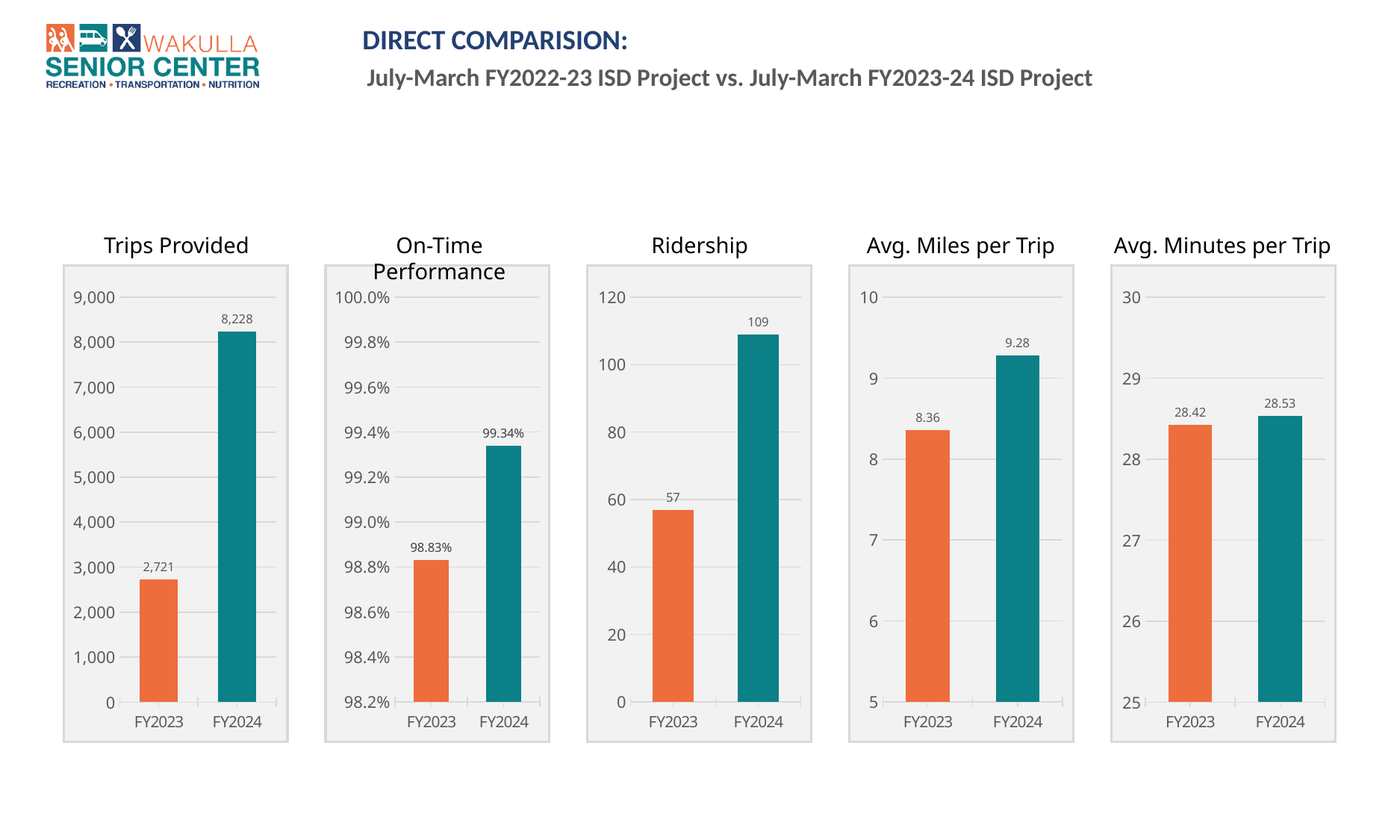
In the Trips Provided chart, what is the difference between the FY2024 and FY2023 values? 5,507 In the Avg. Miles per Trip chart, what is the value for FY2024? 9.28 What kind of chart is the On-Time Performance chart? bar chart In the Trips Provided chart, what is the value for FY2024? 8,228 In the Avg. Miles per Trip chart, which year has the higher value, FY2023 or FY2024? FY2024 In the Trips Provided chart, what is the value for FY2023? 2,721 In the Ridership chart, what is the difference between the FY2024 and FY2023 values? 52 In the Ridership chart, is the value for FY2023 greater or less than 60? less In the On-Time Performance chart, what is the value for FY2023? 98.83% In the Avg. Minutes per Trip chart, what is the value for FY2023? 28.42 How many charts are shown on the slide? 5 In the Ridership chart, what is the value for FY2024? 109